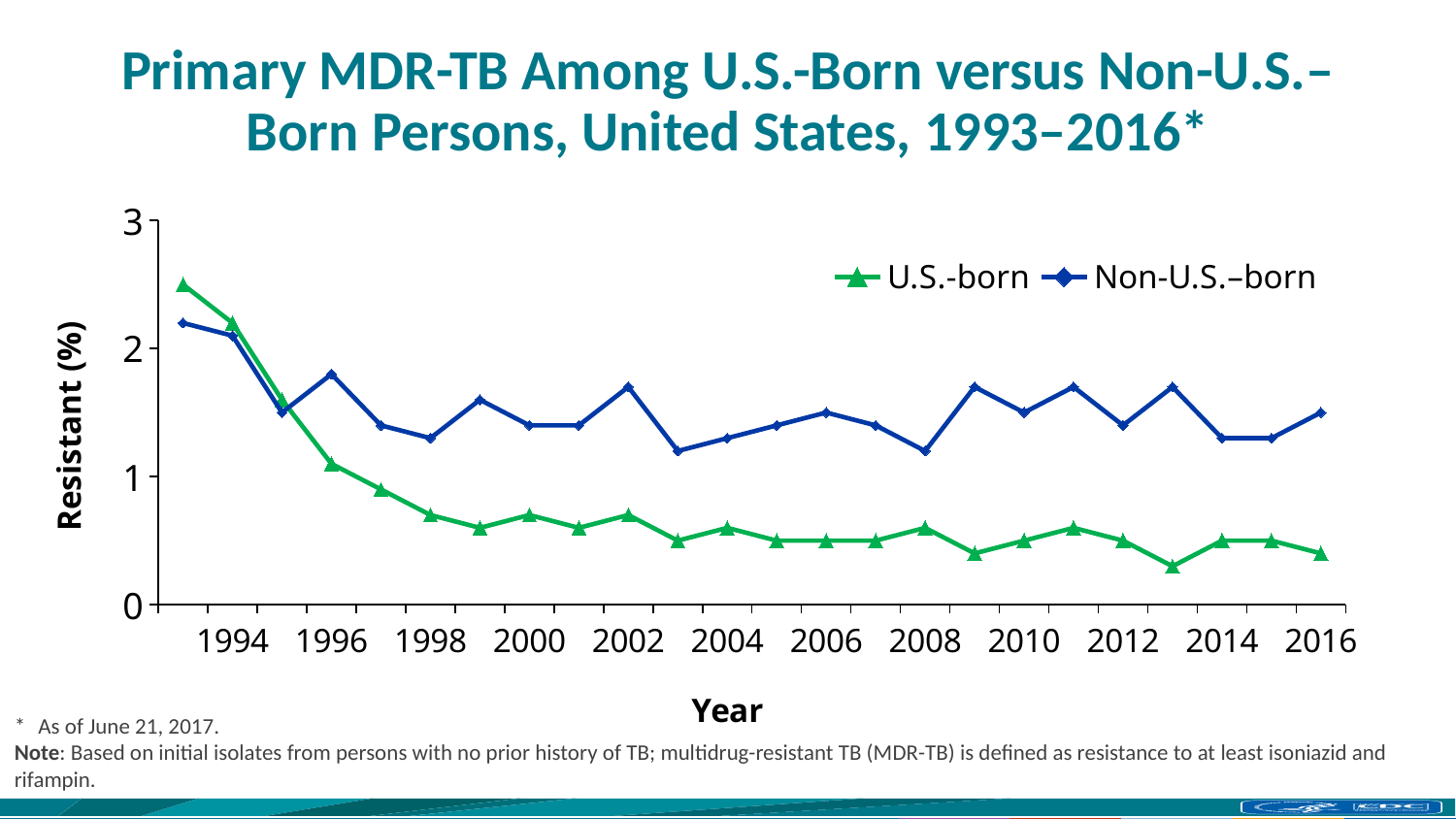
Is the value for U.S.-born in 1993 greater or less than 2? greater Which series has the higher value in 2016, U.S.-born or Non-U.S.–born? Non-U.S.–born What is the label of the y axis? Resistant (%) What kind of chart is shown on the slide? line chart Which series has the higher value in 1993, U.S.-born or Non-U.S.–born? U.S.-born Is the value for Non-U.S.–born in 2016 greater or less than 1? greater Does the U.S.-born series generally rise or fall from 1993 to 2016? fall Is the value for Non-U.S.–born in 1996 greater or less than 2? less In which year is the U.S.-born series at its highest? 1993 What are the two series named in the legend? U.S.-born and Non-U.S.–born How many series does the legend list? 2